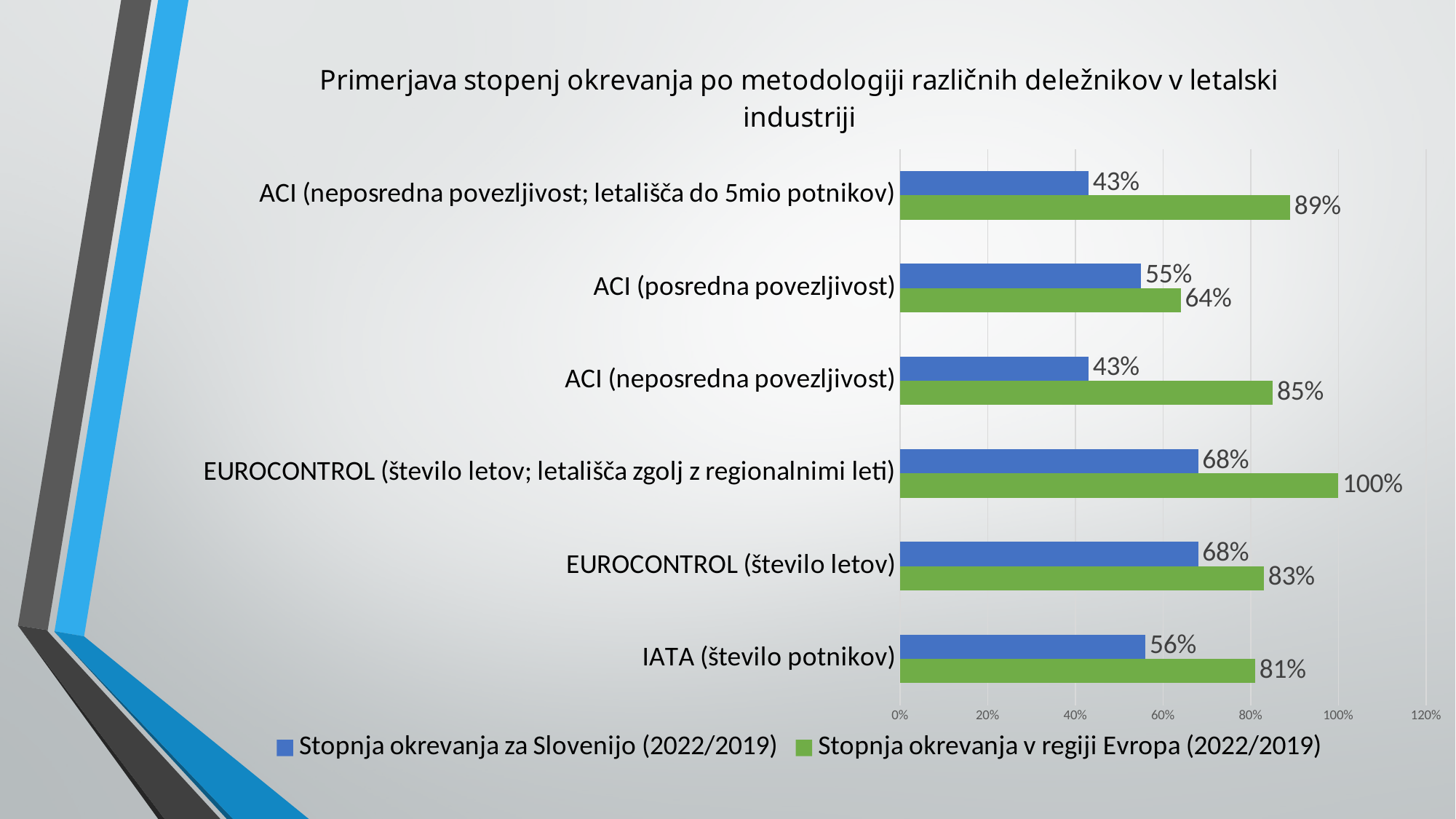
What kind of chart is shown on the slide? bar chart What is the value for 'Stopnja okrevanja v regiji Evropa (2022/2019)' in the category 'EUROCONTROL (število letov; letališča zgolj z regionalnimi leti)'? 100% How many series does the legend list? 2 Is the 'Stopnja okrevanja za Slovenijo (2022/2019)' value for 'ACI (neposredna povezljivost)' greater or less than 60%? less For 'EUROCONTROL (število letov)', which series has the larger value: 'Stopnja okrevanja za Slovenijo (2022/2019)' or 'Stopnja okrevanja v regiji Evropa (2022/2019)'? Stopnja okrevanja v regiji Evropa (2022/2019) Which category has the highest value for 'Stopnja okrevanja v regiji Evropa (2022/2019)'? EUROCONTROL (število letov; letališča zgolj z regionalnimi leti) What is the value for 'Stopnja okrevanja v regiji Evropa (2022/2019)' in the category 'ACI (posredna povezljivost)'? 64% What is the value for 'Stopnja okrevanja za Slovenijo (2022/2019)' in the category 'IATA (število potnikov)'? 56% Which category has the lowest value for 'Stopnja okrevanja v regiji Evropa (2022/2019)'? ACI (posredna povezljivost) What is the difference between the 'Stopnja okrevanja v regiji Evropa (2022/2019)' and 'Stopnja okrevanja za Slovenijo (2022/2019)' values for 'ACI (neposredna povezljivost; letališča do 5mio potnikov)'? 46% How many categories are shown on the chart? 6 What colour represents 'Stopnja okrevanja za Slovenijo (2022/2019)' in the chart? blue